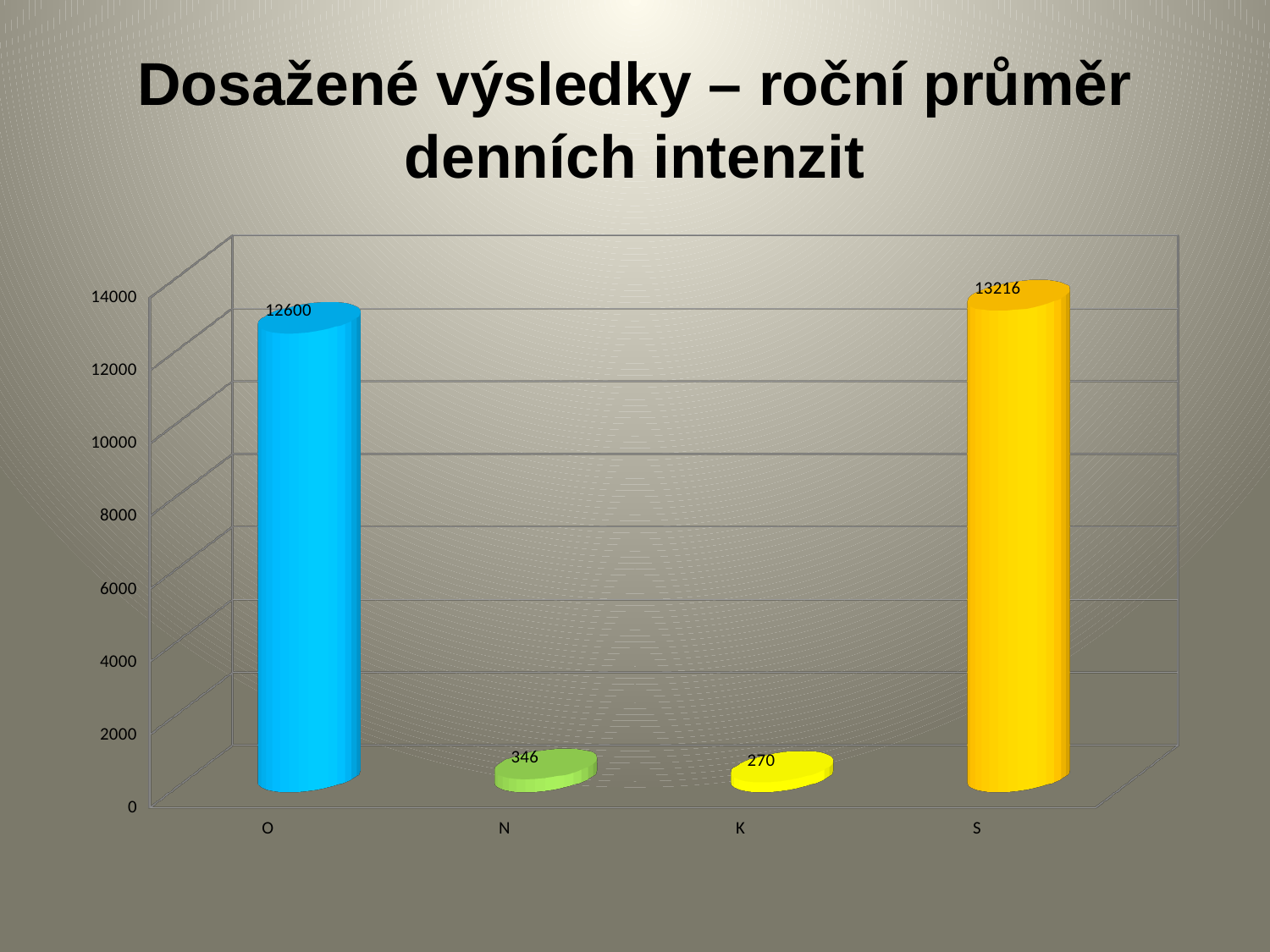
What is the difference between the values for S and O? 616 How many categories are shown on the x axis? 4 What is the value for category N? 346 What is the difference between the values for N and K? 76 What is the value for category O? 12600 Which category has the lowest value? K What is the value for category S? 13216 Which is larger, the value for O or the value for S? S Which category has the highest value? S What is the value for category K? 270 What kind of chart is shown on the slide? bar chart What is the title of the slide? Dosažené výsledky – roční průměr denních intenzit